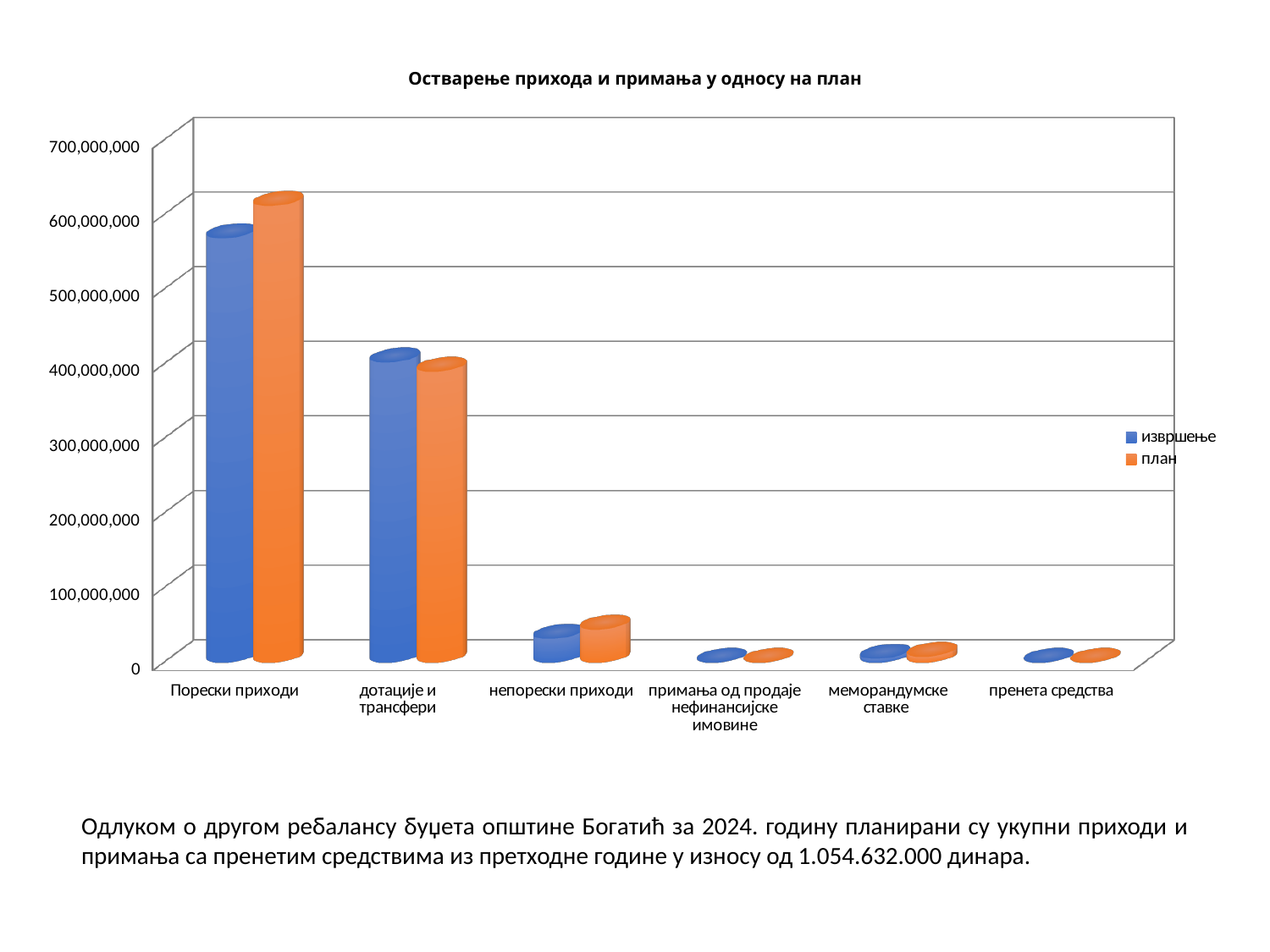
What kind of chart is shown on the slide? bar chart Is the извршење value for дотације и трансфери greater or less than 300,000,000? greater How many series does the legend list? 2 Which colour represents the план series in the legend? orange How many categories are shown on the x axis? 6 Which category has the highest value for извршење? Порески приходи For дотације и трансфери, which is larger: извршење or план? извршење Which category has the highest value for план? Порески приходи What is the title of the chart? Остварење прихода и примања у односу на план Is the план value for непорески приходи greater or less than 100,000,000? less Is the извршење value for Порески приходи greater or less than 600,000,000? less For Порески приходи, which is larger: извршење or план? план